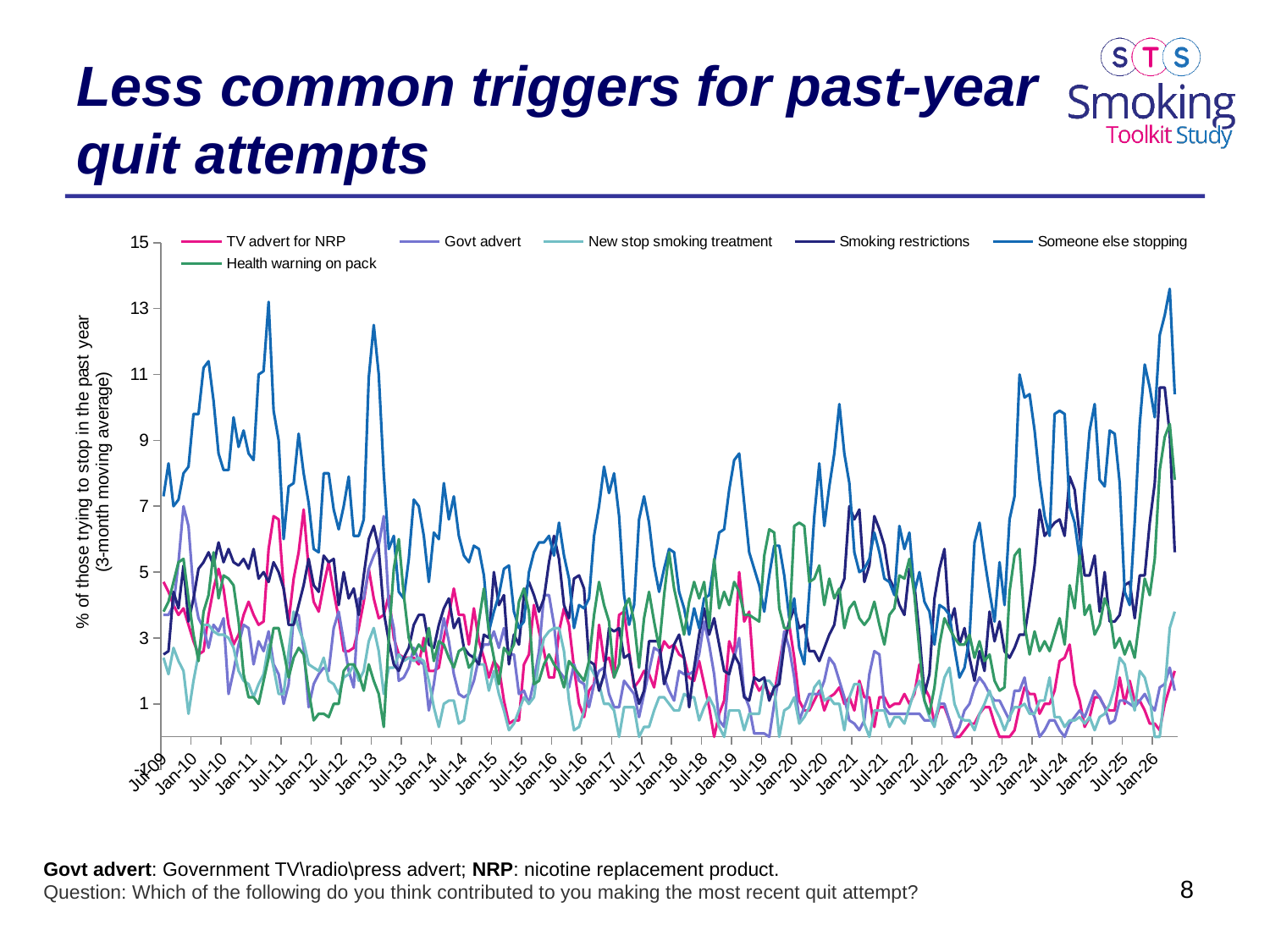
What kind of chart is shown on the slide? line chart Is the value for TV advert for NRP at Jan-24 greater or less than 5? less Is the highest value reached by the Govt advert series greater or less than 9? less Is the highest value reached by the Someone else stopping series greater or less than 13? greater Around Jan-26, which series is higher: Someone else stopping or TV advert for NRP? Someone else stopping Which series has the highest values across most of the period? Someone else stopping What is the last date label on the x axis? Jan-26 What is the label on the y axis? % of those trying to stop in the past year (3-month moving average) How many series does the legend list? 6